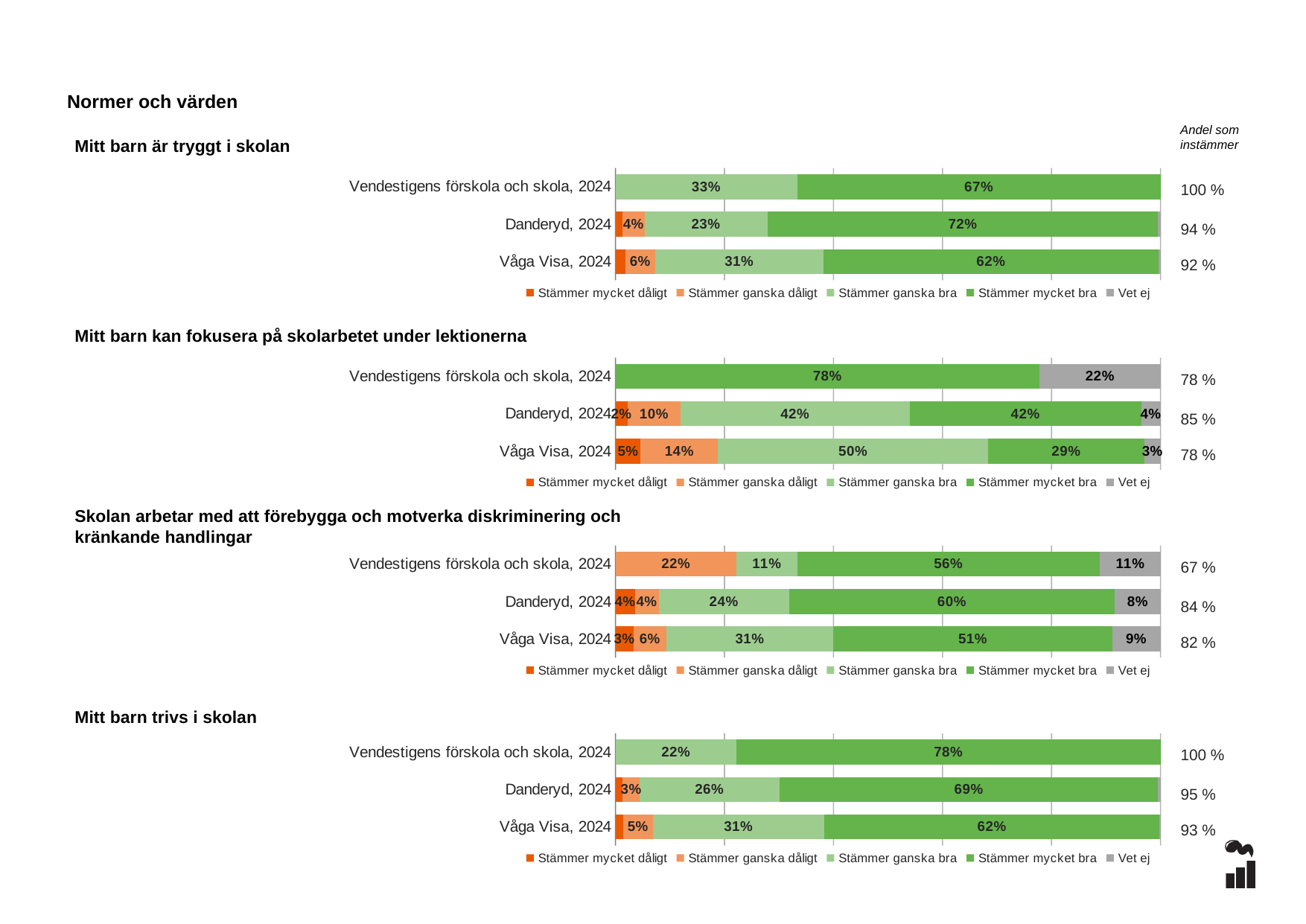
In the chart 'Mitt barn trivs i skolan', which is larger: the 'Stämmer ganska bra' value for Danderyd, 2024 or for Våga Visa, 2024? Våga Visa, 2024 In the chart 'Mitt barn är tryggt i skolan', what is the 'Stämmer mycket bra' value for Vendestigens förskola och skola, 2024? 67% What kind of chart is 'Mitt barn är tryggt i skolan'? Stacked bar chart In the chart 'Skolan arbetar med att förebygga och motverka diskriminering och kränkande handlingar', what is the 'Stämmer ganska dåligt' value for Vendestigens förskola och skola, 2024? 22% In the chart 'Mitt barn kan fokusera på skolarbetet under lektionerna', what is the 'Vet ej' value for Vendestigens förskola och skola, 2024? 22% In the chart 'Skolan arbetar med att förebygga och motverka diskriminering och kränkande handlingar', which row has the highest 'Stämmer mycket bra' value? Danderyd, 2024 How many rows (categories) are shown in the chart 'Mitt barn kan fokusera på skolarbetet under lektionerna'? 3 In the chart 'Mitt barn trivs i skolan', what is the difference between the 'Stämmer mycket bra' values for Vendestigens förskola och skola, 2024 and Våga Visa, 2024? 16% In the chart 'Mitt barn kan fokusera på skolarbetet under lektionerna', what is the 'Stämmer ganska bra' value for Våga Visa, 2024? 50% How many series does the legend list under the chart 'Mitt barn trivs i skolan'? 5 In the chart 'Mitt barn kan fokusera på skolarbetet under lektionerna', what is the 'Andel som instämmer' value for Danderyd, 2024? 85 % In the chart 'Mitt barn är tryggt i skolan', what is the 'Stämmer ganska bra' value for Danderyd, 2024? 23%